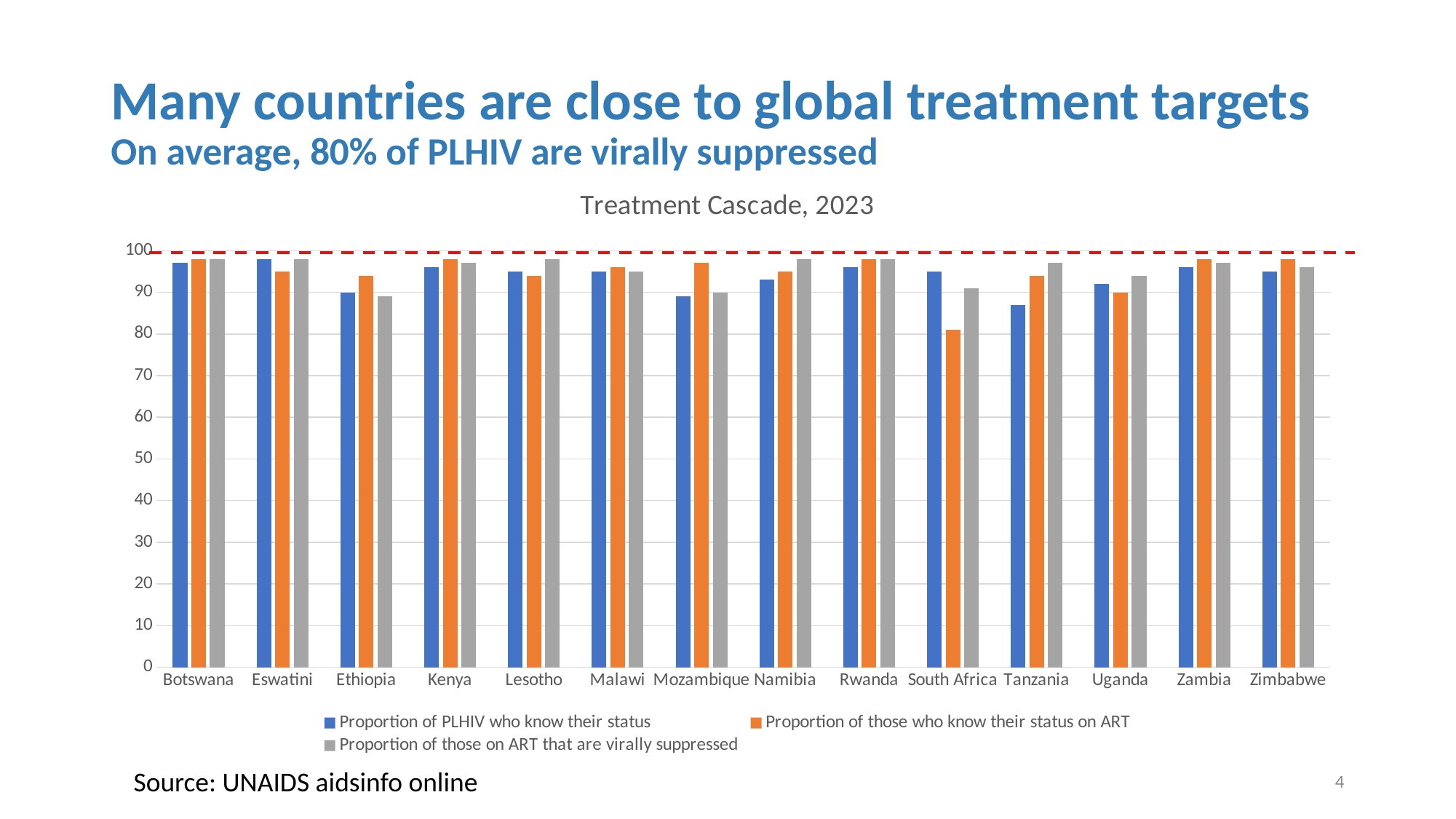
How many countries are shown on the x axis of the chart? 14 What is the title of the chart? Treatment Cascade, 2023 Which country has the lowest value for Proportion of those who know their status on ART? South Africa Is the value for Proportion of those who know their status on ART in South Africa greater or less than 90? less How many series does the chart's legend list? 3 Is the value for Proportion of PLHIV who know their status in Botswana greater or less than 90? greater Is the value for Proportion of PLHIV who know their status in Tanzania greater or less than 90? less In South Africa, which is larger: Proportion of PLHIV who know their status or Proportion of those who know their status on ART? Proportion of PLHIV who know their status Which series is shown in orange in the chart? Proportion of those who know their status on ART What kind of chart is shown on the slide? bar chart In Tanzania, which is larger: Proportion of PLHIV who know their status or Proportion of those on ART that are virally suppressed? Proportion of those on ART that are virally suppressed